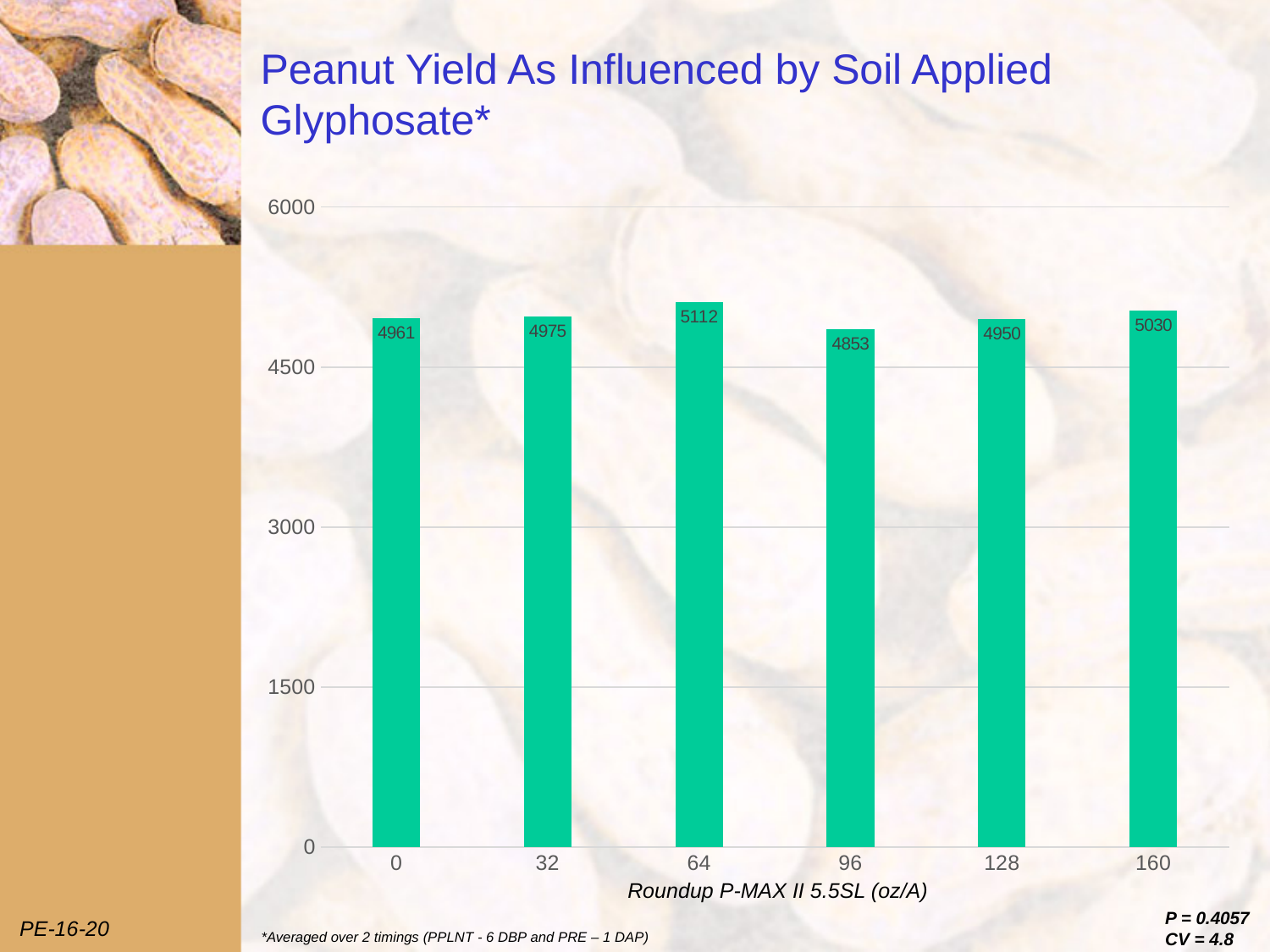
Which Roundup P-MAX II 5.5SL rate gives the lowest peanut yield? 96 Which has the larger peanut yield, the 128 oz/A rate or the 160 oz/A rate? 160 oz/A How many Roundup P-MAX II 5.5SL rates are shown on the chart? 6 What is the difference in peanut yield between the 64 oz/A and 96 oz/A rates? 259 What is the difference in peanut yield between the 32 oz/A and 0 oz/A rates? 14 What is the peanut yield at 64 oz/A of Roundup P-MAX II 5.5SL? 5112 What is the x-axis label of the chart? Roundup P-MAX II 5.5SL (oz/A) What kind of chart is shown on the slide? Bar chart Which Roundup P-MAX II 5.5SL rate gives the highest peanut yield? 64 What is the peanut yield at 0 oz/A of Roundup P-MAX II 5.5SL? 4961 What is the peanut yield at 96 oz/A of Roundup P-MAX II 5.5SL? 4853 What is the peanut yield at 160 oz/A of Roundup P-MAX II 5.5SL? 5030